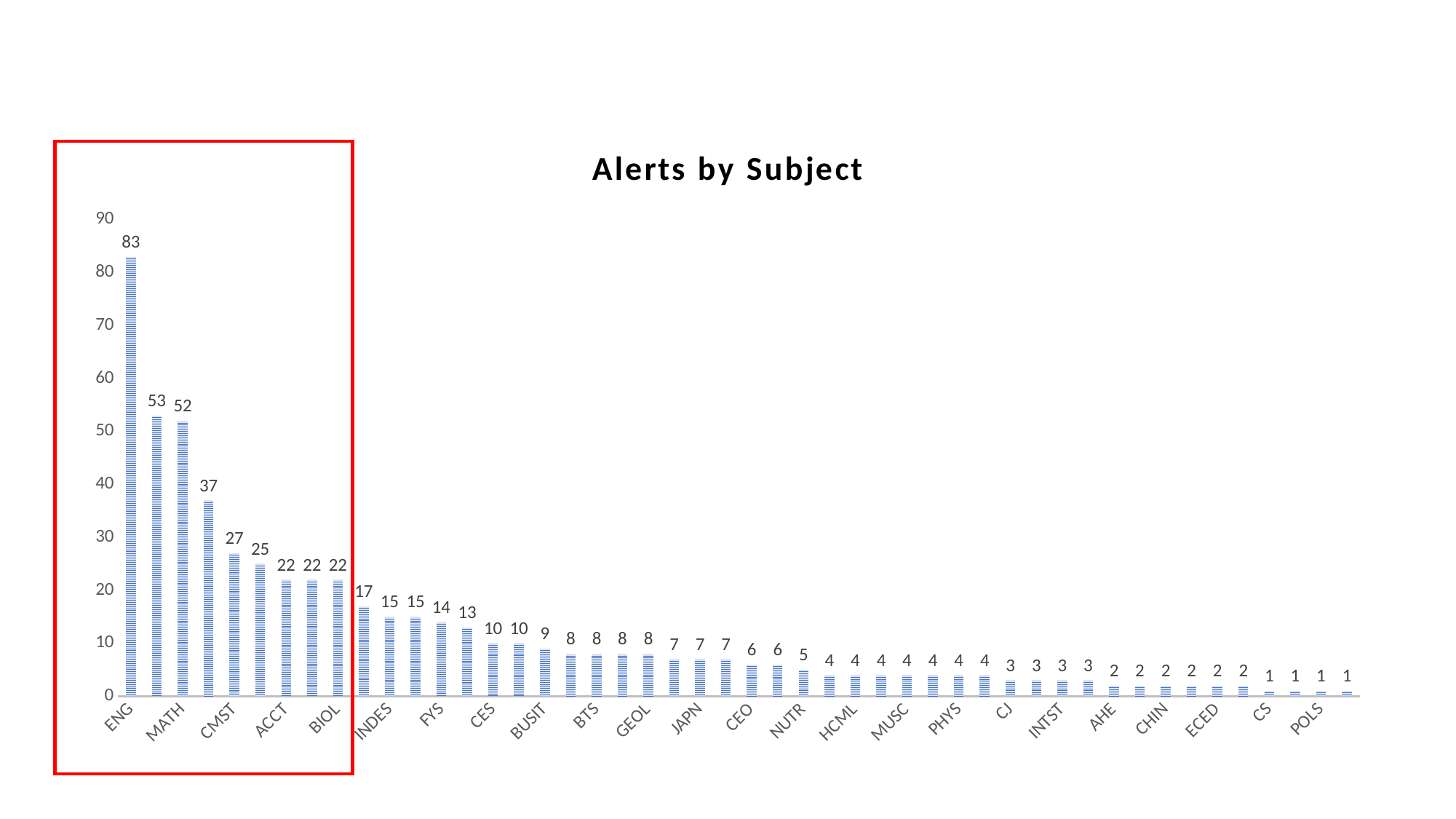
What kind of chart is shown on the slide? bar chart Which subject has the highest number of alerts? ENG Which has more alerts, ENG or MATH? ENG What is the value for CMST? 27 What is the value for NUTR? 5 What is the value for FYS? 14 What is the value for ENG? 83 What is the difference between the highest value (83) and the lowest value (1)? 82 What is the lowest value shown on the chart? 1 Do the values rise or fall from left to right along the x axis? fall Is the value for ENG greater or less than 80? greater What is the title of the chart? Alerts by Subject